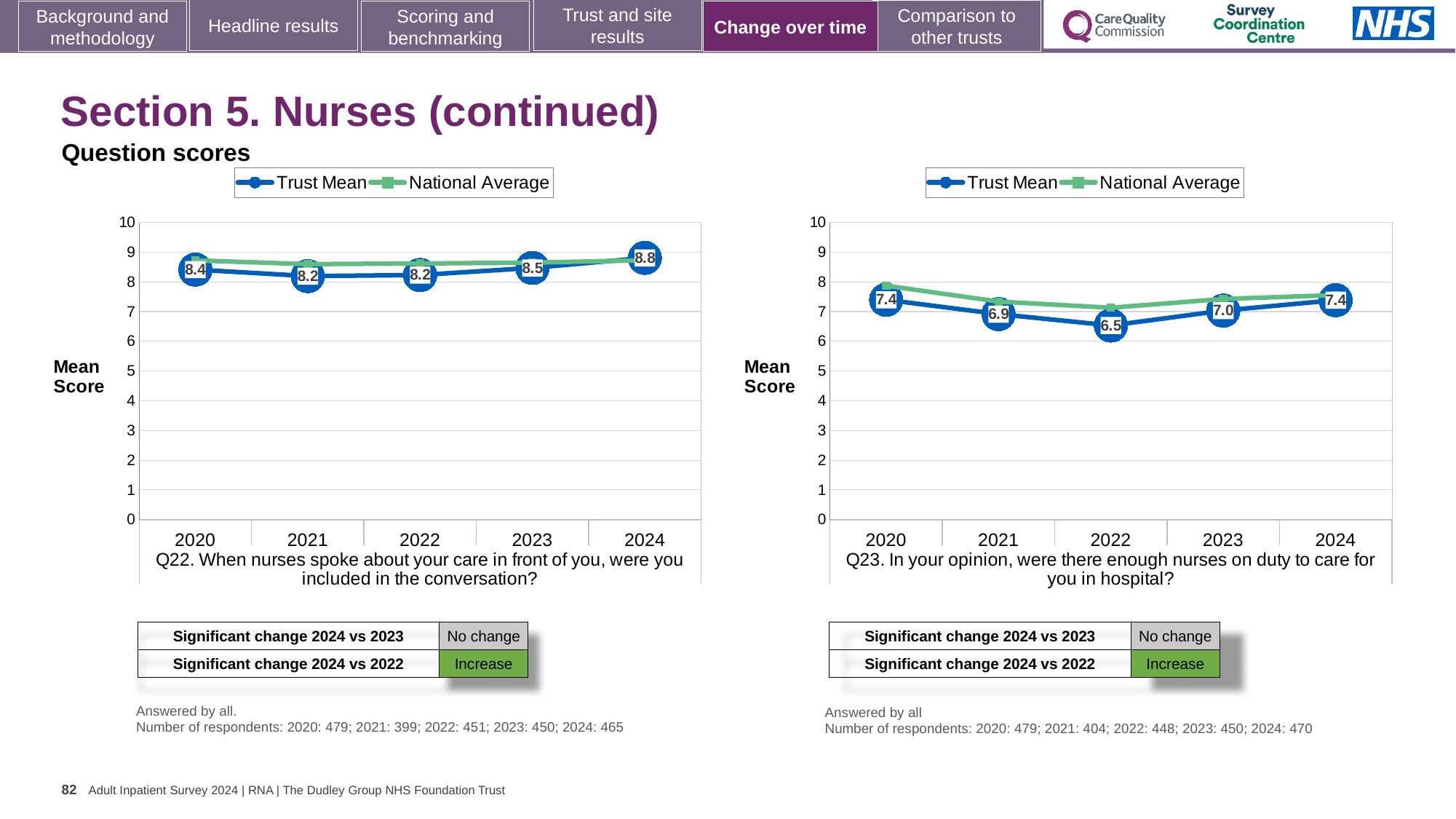
How many years are plotted on the Q22 chart (left)? 5 On the Q23 chart (right), what is the difference between the Trust Mean scores for 2024 and 2022? 0.9 On the Q22 chart (left), is the Trust Mean score for 2023 larger or smaller than the score for 2021? larger On the Q22 chart (left), which year has the highest Trust Mean score? 2024 On the Q23 chart (right), which year has the lowest Trust Mean score? 2022 On the Q23 chart (right), what is the Trust Mean score for 2022? 6.5 On the Q23 chart (right), is the National Average for 2020 greater or less than 7? greater On the Q23 chart (right), what is the Trust Mean score for 2021? 6.9 On the Q22 chart (left), what is the Trust Mean score for 2020? 8.4 What type of chart is used for Q22 (left)? Line chart On the Q22 chart (left), what is the Trust Mean score for 2024? 8.8 How many series does the legend of the Q23 chart (right) list? 2